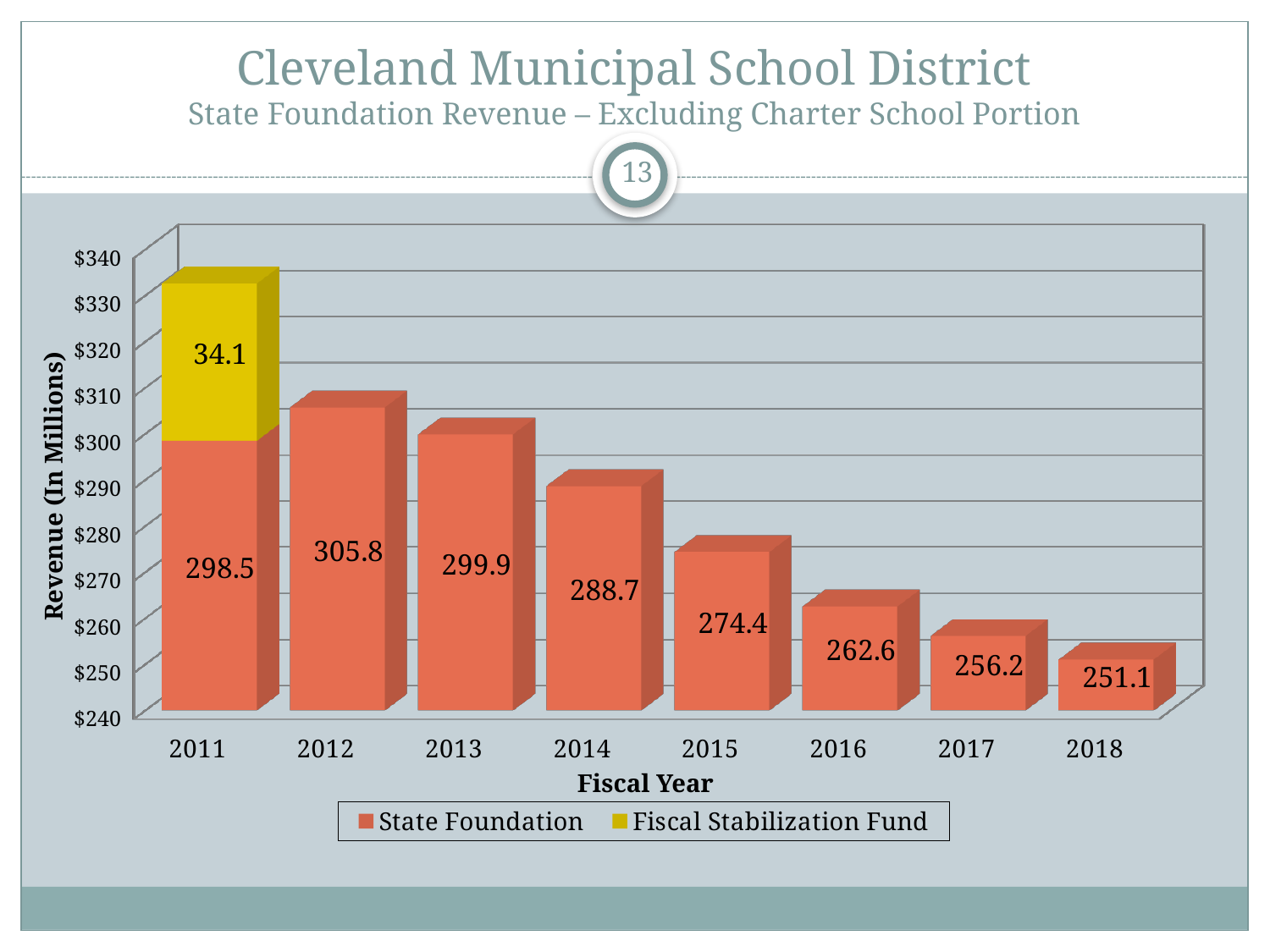
Do the State Foundation values rise or fall from 2012 to 2018? Fall How many series does the legend list? 2 What is the State Foundation value for 2012? 305.8 What is the Fiscal Stabilization Fund value for 2011? 34.1 What is the State Foundation value for 2018? 251.1 Which fiscal year has the lowest State Foundation value? 2018 What is the difference between the State Foundation values for 2012 and 2018? 54.7 Which fiscal year has the highest State Foundation value? 2012 What is the total of the stacked bar for 2011? 332.6 What kind of chart is shown on the slide? Bar chart How many fiscal years are shown on the x axis? 8 Which is larger, the State Foundation value for 2014 or for 2015? 2014